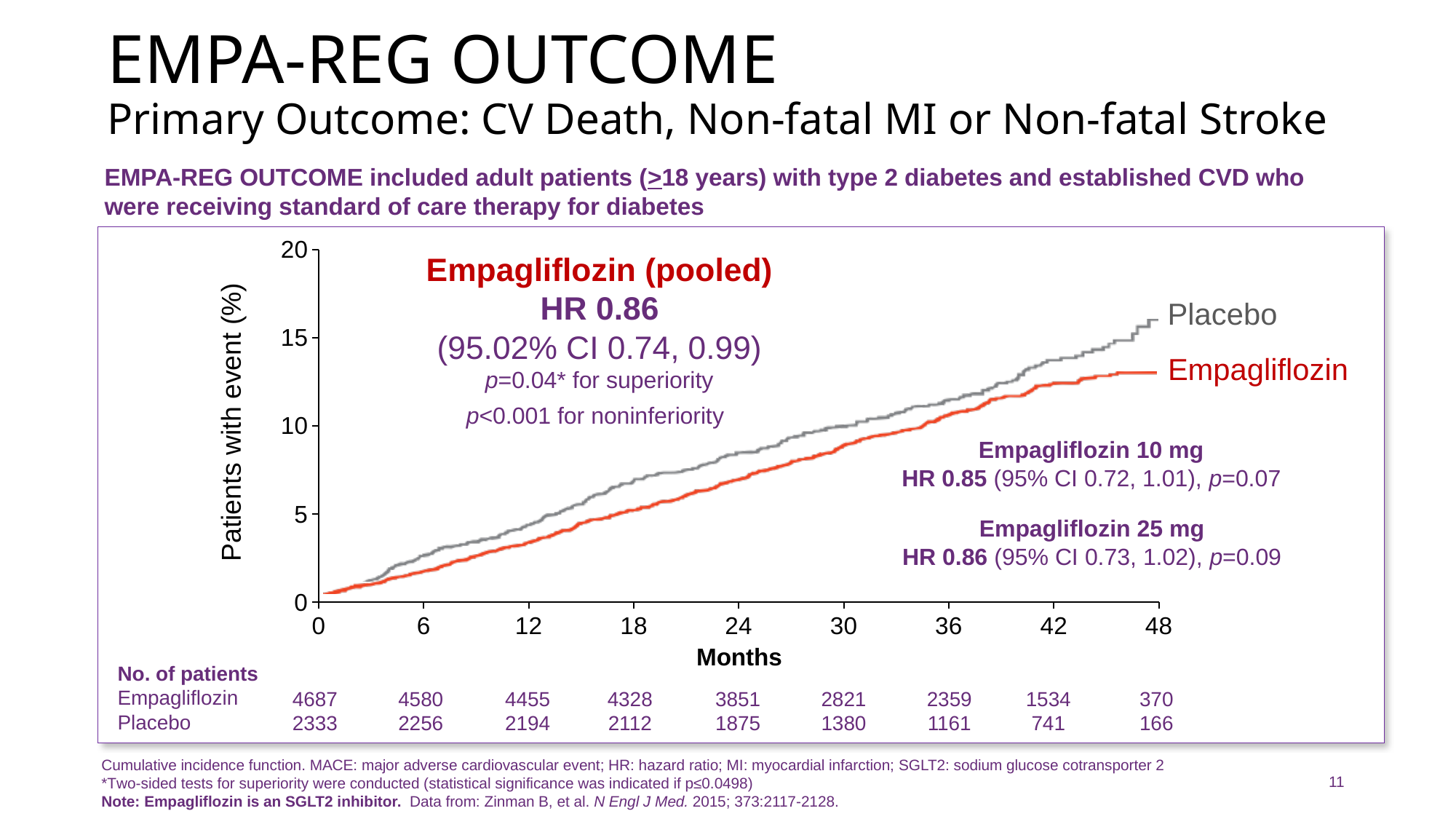
How many treatment groups (series) are plotted in the chart? 2 Is the Placebo curve at 48 months greater or less than 15%? greater How many patients were in the Empagliflozin group at 0 months according to the No. of patients table? 4687 Do the cumulative incidence curves rise or fall as months increase? Rise Is the Empagliflozin curve at 48 months greater or less than 15%? less How many patients were in the Placebo group at 48 months according to the No. of patients table? 166 What is the highest value shown on the y-axis? 20 What is the difference between the number of Empagliflozin and Placebo patients at 0 months? 2354 What is the label of the y-axis? Patients with event (%) What is the hazard ratio shown for Empagliflozin (pooled)? 0.86 What kind of chart is shown on the slide? Line chart At 48 months, which curve is higher, Placebo or Empagliflozin? Placebo